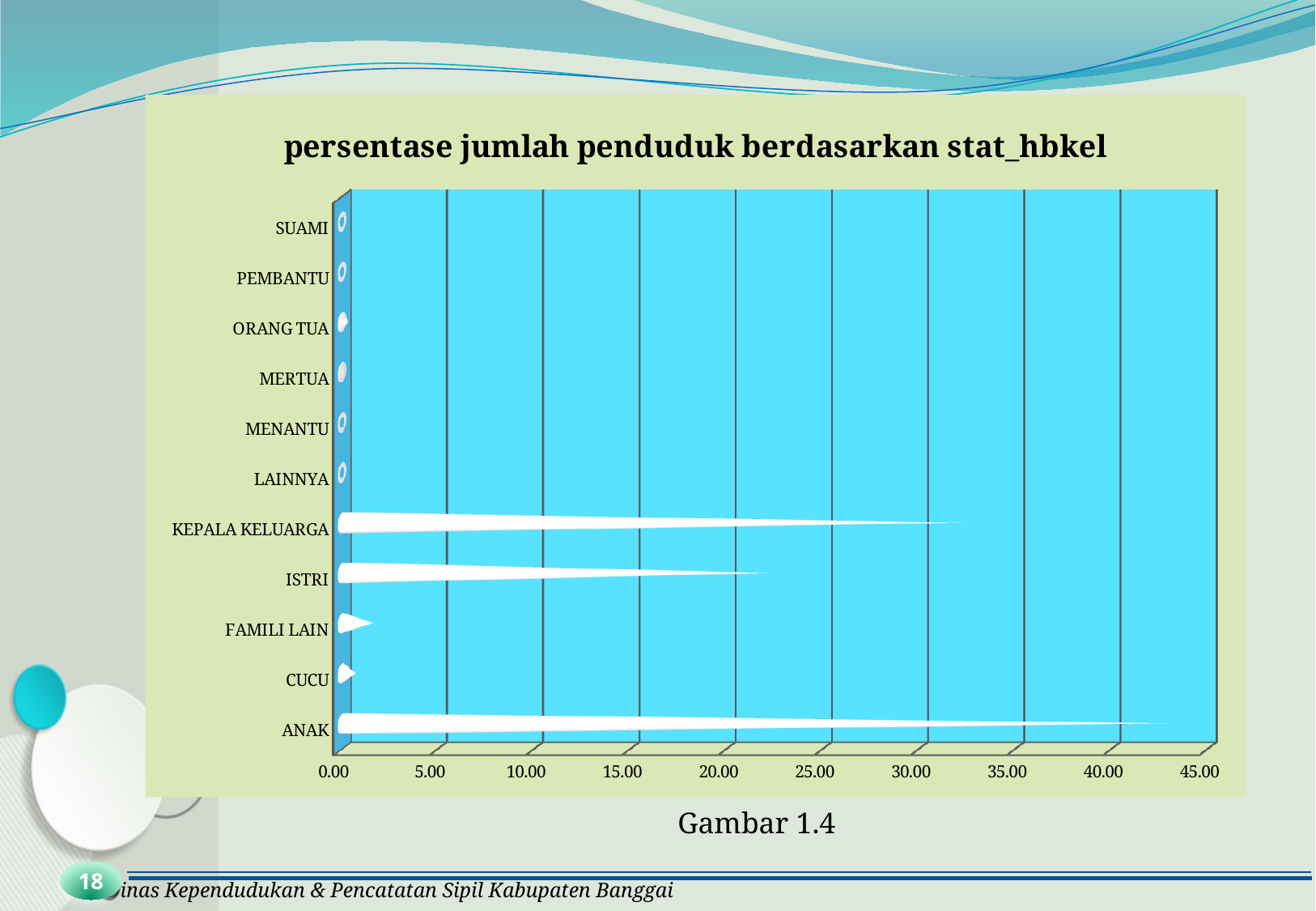
Is the value for FAMILI LAIN greater or less than 5.00? less Which is larger, the value for ANAK or the value for KEPALA KELUARGA? ANAK How many categories are plotted on the chart? 11 What is the highest value shown on the horizontal axis? 45.00 What is the title of the chart? persentase jumlah penduduk berdasarkan stat_hbkel Which category has the highest value? ANAK Is the value for ISTRI greater or less than 25.00? less What kind of chart is shown on the slide? bar chart Which is larger, the value for KEPALA KELUARGA or the value for ISTRI? KEPALA KELUARGA Is the value for ANAK greater or less than 40.00? greater Which is larger, the value for FAMILI LAIN or the value for ISTRI? ISTRI